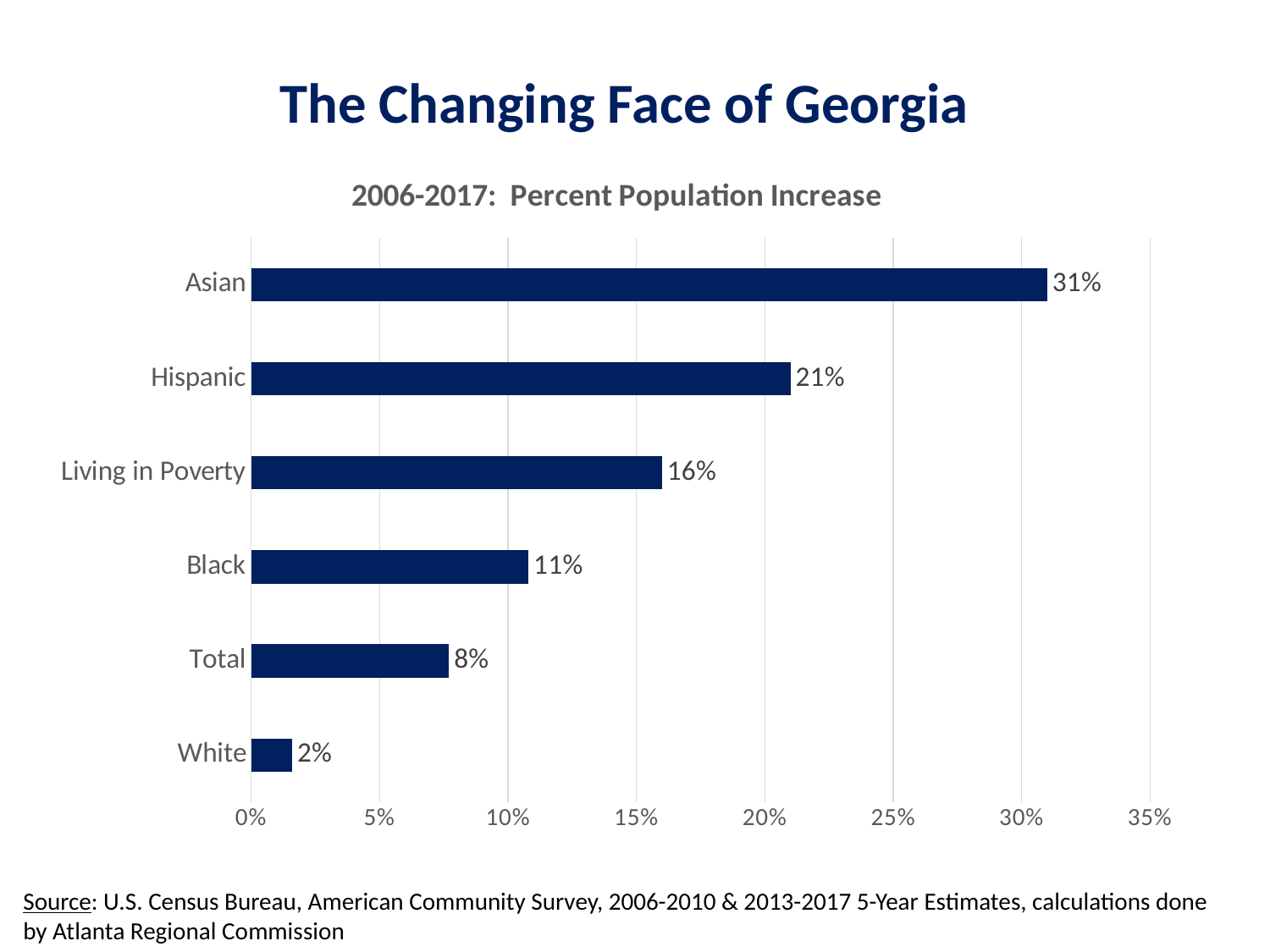
How many categories are shown in the chart? 6 Which category has the lowest percent population increase? White Is the value for Living in Poverty greater or less than 15%? greater What is the percent population increase for Living in Poverty? 16% What is the difference between the percent population increase for Asian and Hispanic? 10% Which category has the highest percent population increase? Asian Which has a larger percent population increase, Black or Total? Black What is the percent population increase for Hispanic? 21% What is the percent population increase for White? 2% What kind of chart is shown on the slide? Bar chart What is the title of the chart? 2006-2017: Percent Population Increase What is the percent population increase for Asian? 31%